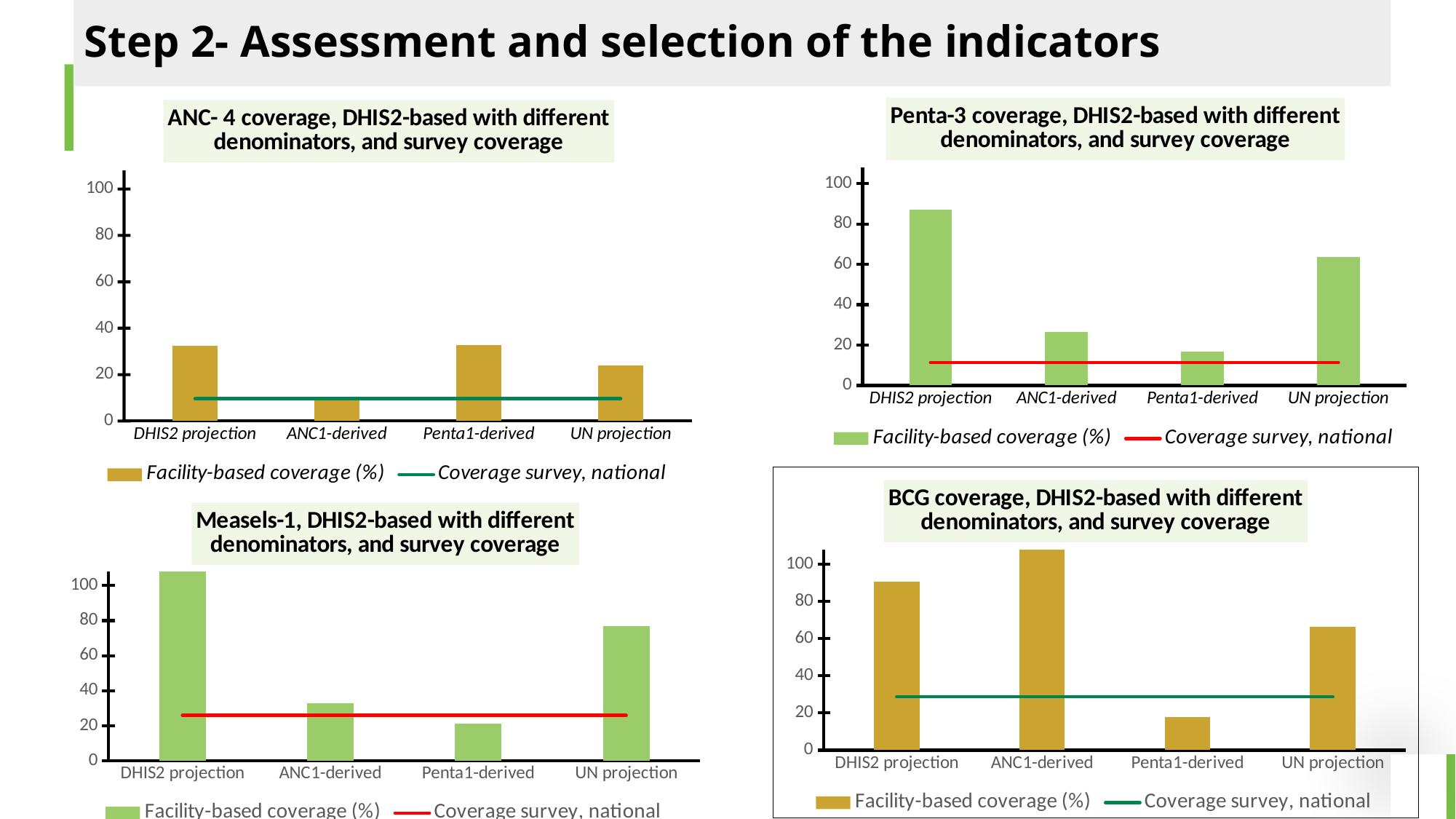
In the BCG coverage chart, which category has the lowest facility-based coverage? Penta1-derived In the ANC-4 coverage chart, which category has the lowest facility-based coverage? ANC1-derived In the Measels-1 coverage chart, which category has the highest facility-based coverage? DHIS2 projection In the Penta-3 coverage chart, which category has the lowest facility-based coverage? Penta1-derived In the Measels-1 coverage chart, which is larger: the facility-based coverage for UN projection or for ANC1-derived? UN projection What kind of chart is used to show facility-based coverage in the Measels-1 coverage chart? bar chart How many series does the legend of the BCG coverage chart list? 2 In the Penta-3 coverage chart, is the facility-based coverage for DHIS2 projection greater or less than 80? greater In the BCG coverage chart, which category has the highest facility-based coverage? ANC1-derived In the Penta-3 coverage chart, which category has the highest facility-based coverage? DHIS2 projection In the BCG coverage chart, is the facility-based coverage for Penta1-derived greater or less than 20? less How many categories are shown on the x axis of the ANC-4 coverage chart? 4